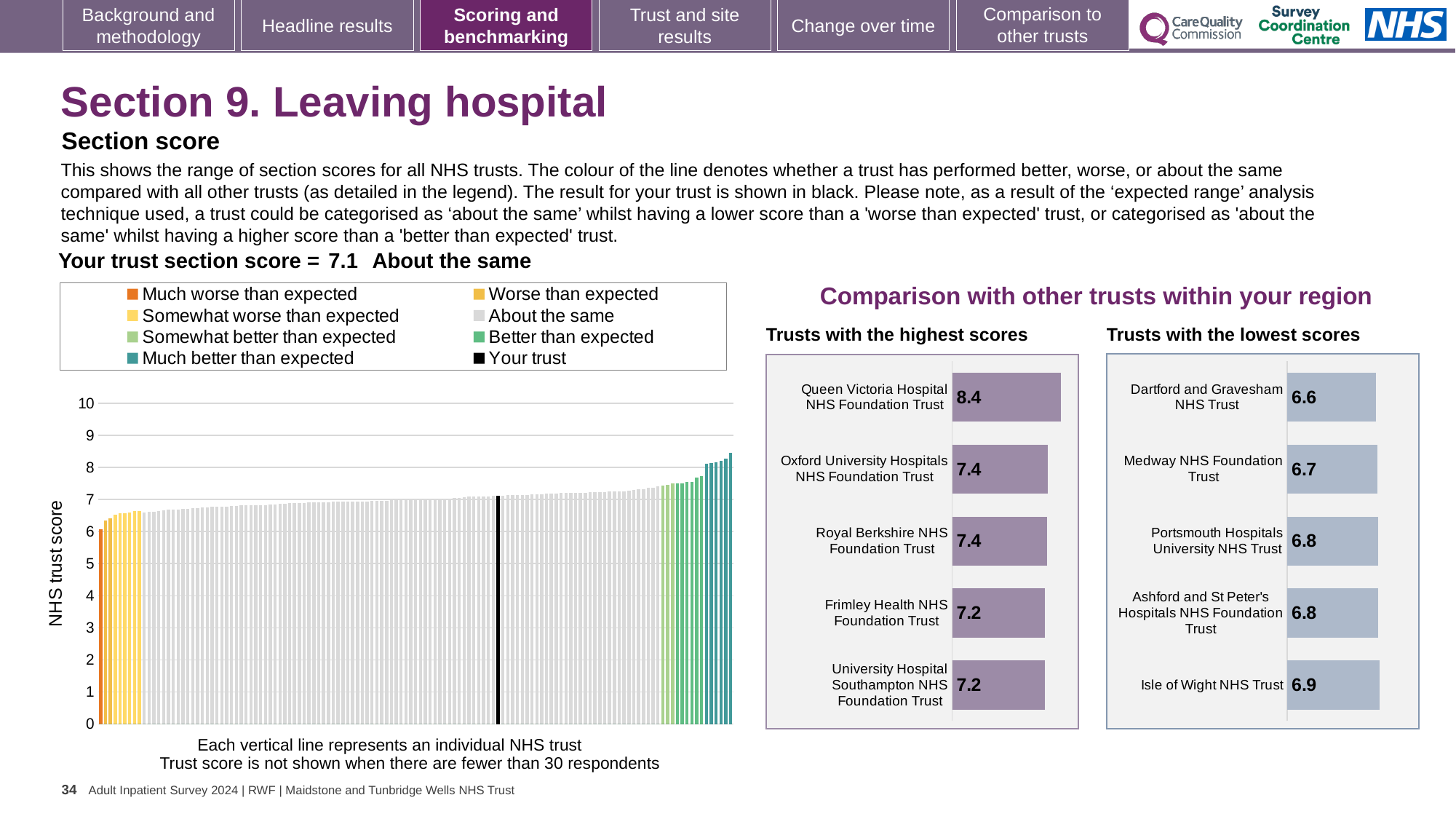
How many trusts are shown in the 'Trusts with the highest scores' chart? 5 What kind of chart is the main NHS trust score chart on the left? Bar chart In the main NHS trust score chart on the left, what is the section score for your trust? 7.1 In the 'Trusts with the lowest scores' chart, what is the difference between the scores of Isle of Wight NHS Trust and Dartford and Gravesham NHS Trust? 0.3 In the 'Trusts with the highest scores' chart, what is the difference between the scores of Queen Victoria Hospital NHS Foundation Trust and Frimley Health NHS Foundation Trust? 1.2 In the 'Trusts with the lowest scores' chart, which trust has the lowest score? Dartford and Gravesham NHS Trust In the 'Trusts with the lowest scores' chart, which has the higher score: Medway NHS Foundation Trust or Isle of Wight NHS Trust? Isle of Wight NHS Trust How many entries does the legend of the main NHS trust score chart on the left list? 8 In the 'Trusts with the highest scores' chart, what is the score for Queen Victoria Hospital NHS Foundation Trust? 8.4 In the 'Trusts with the lowest scores' chart, what is the score for Isle of Wight NHS Trust? 6.9 In the main NHS trust score chart on the left, is the value of the tallest bar greater or less than 8? greater In the 'Trusts with the highest scores' chart, which trust has the highest score? Queen Victoria Hospital NHS Foundation Trust